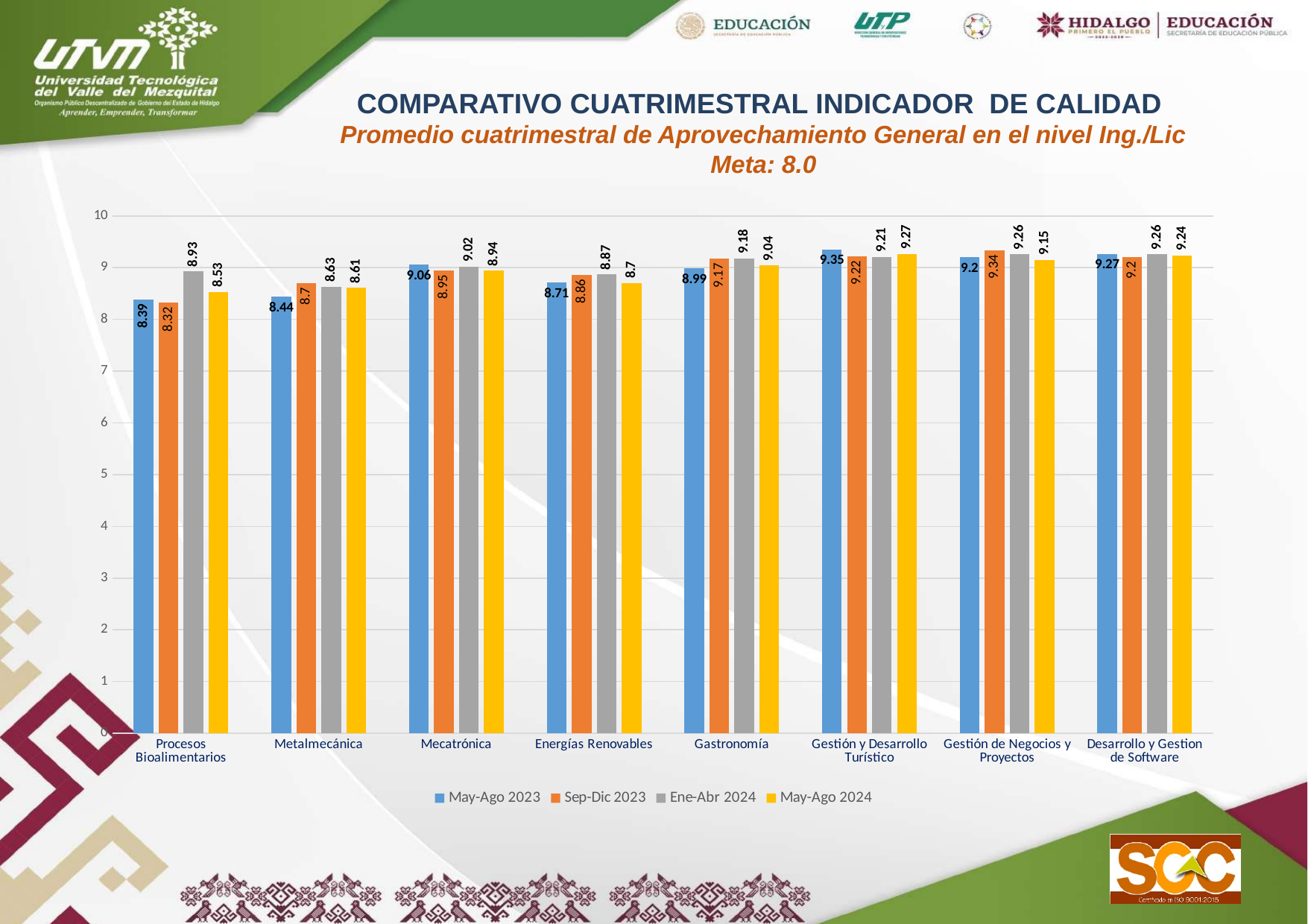
What is the difference between the Ene-Abr 2024 and May-Ago 2023 values for Procesos Bioalimentarios? 0.54 What is the value for Procesos Bioalimentarios in the May-Ago 2023 series? 8.39 What kind of chart is shown on the slide? Bar chart Which category has the highest value in the May-Ago 2024 series? Gestión y Desarrollo Turístico What is the value for Energías Renovables in the May-Ago 2024 series? 8.7 Which category has the lowest value in the Sep-Dic 2023 series? Procesos Bioalimentarios How many categories (programs) are shown on the x axis? 8 What is the value for Gestión de Negocios y Proyectos in the Sep-Dic 2023 series? 9.34 For Metalmecánica, which is larger: the Sep-Dic 2023 value or the May-Ago 2023 value? Sep-Dic 2023 How many series does the legend list? 4 What target (Meta) is stated in the chart title? 8.0 What is the value for Gastronomía in the Ene-Abr 2024 series? 9.18